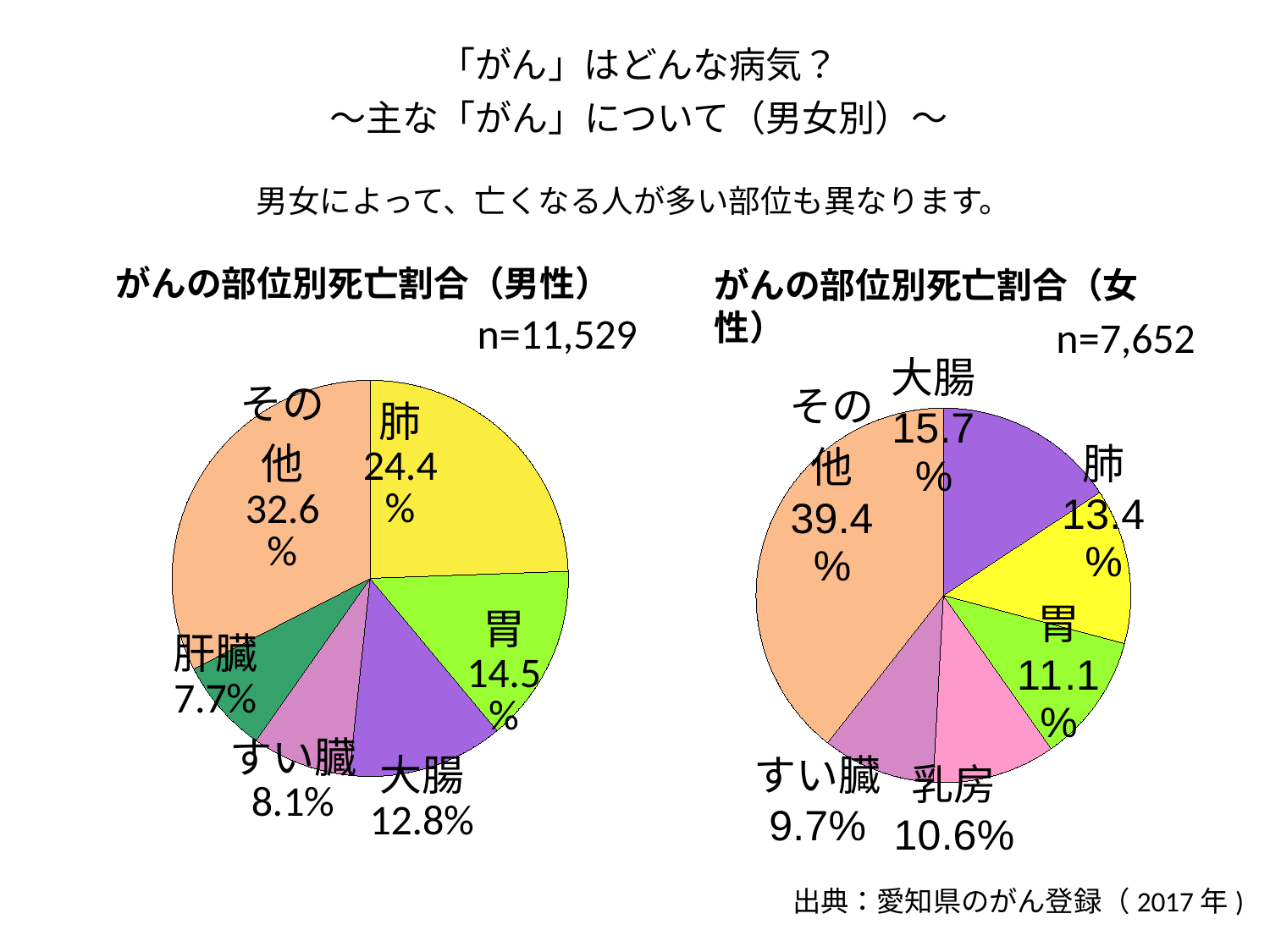
In the がんの部位別死亡割合（男性） chart, what share is 肝臓? 7.7% What is the n value shown for the がんの部位別死亡割合（男性） chart? n=11,529 What is the n value shown for the がんの部位別死亡割合（女性） chart? n=7,652 In the がんの部位別死亡割合（男性） chart, what is the difference between the 胃 share and the 大腸 share? 1.7% In the がんの部位別死亡割合（女性） chart, what share is その他? 39.4% In the がんの部位別死亡割合（男性） chart, what share is 肺? 24.4% In the がんの部位別死亡割合（女性） chart, which named organ (excluding その他) has the smallest share? すい臓 What type of chart is used for がんの部位別死亡割合（女性）? Pie chart In the がんの部位別死亡割合（女性） chart, what share is 乳房? 10.6% How many slices does the がんの部位別死亡割合（男性） pie chart have? 6 In the がんの部位別死亡割合（女性） chart, which is larger, 大腸 or 肺? 大腸 In the がんの部位別死亡割合（男性） chart, which named organ (excluding その他) has the largest share? 肺